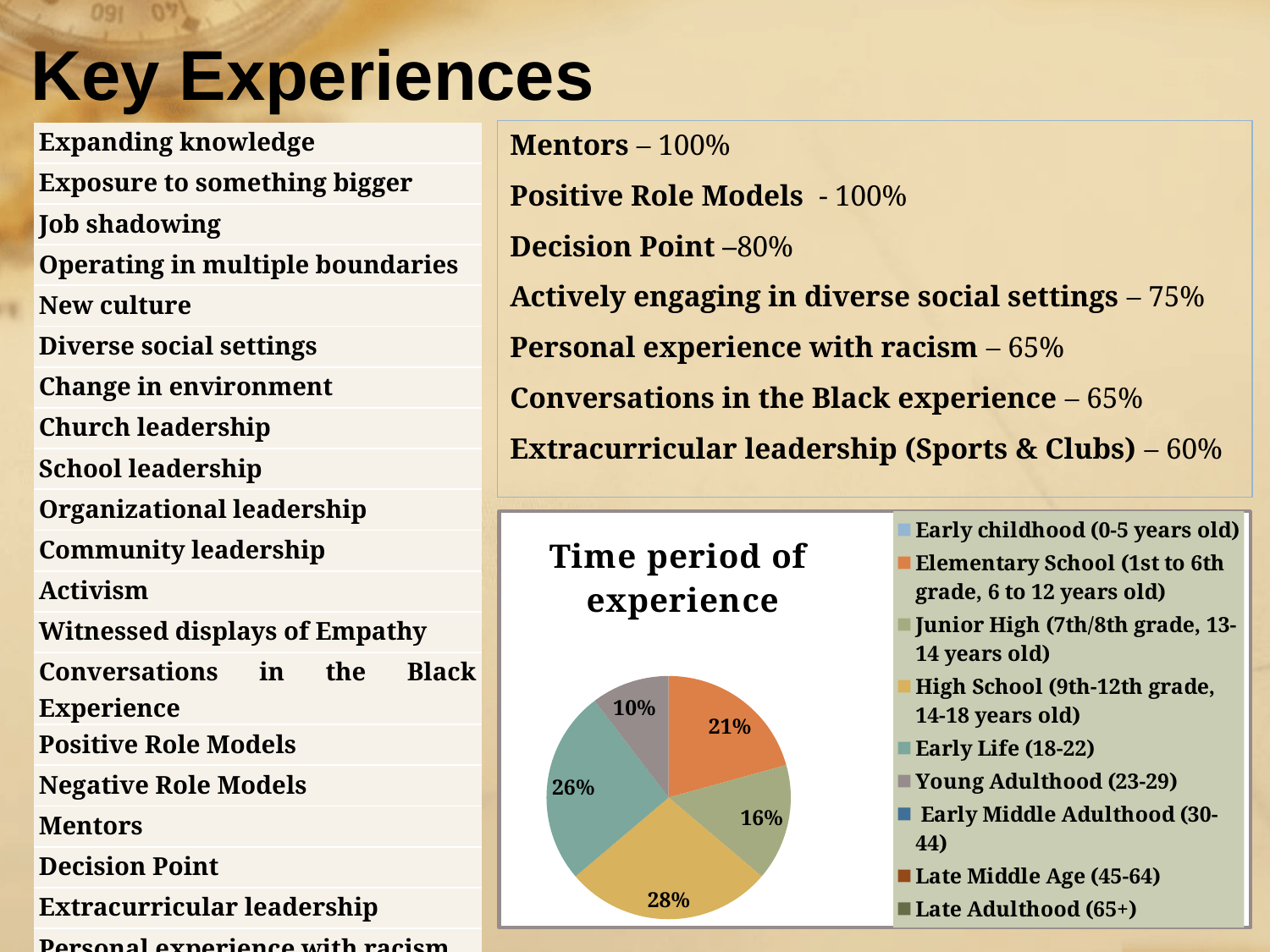
In the pie chart, what share is labelled for the High School (9th-12th grade, 14-18 years old) slice? 28% In the pie chart, what share is labelled for the Young Adulthood (23-29) slice? 10% In the pie chart, what share is labelled for the Junior High (7th/8th grade, 13-14 years old) slice? 16% In the pie chart, which slice is larger: Elementary School or Early Life (18-22)? Early Life (18-22) What is the difference in percentage points between the High School slice and the Junior High slice in the pie chart? 12 percentage points Which labelled slice in the pie chart is the smallest? Young Adulthood (23-29) In the pie chart, what share is labelled for the Early Life (18-22) slice? 26% How many entries does the legend of the pie chart list? 9 In the pie chart, what share is labelled for the Elementary School (1st to 6th grade, 6 to 12 years old) slice? 21% Which time period has the largest slice in the pie chart? High School (9th-12th grade, 14-18 years old) What kind of chart is shown on the slide? Pie chart What is the title of the pie chart? Time period of experience